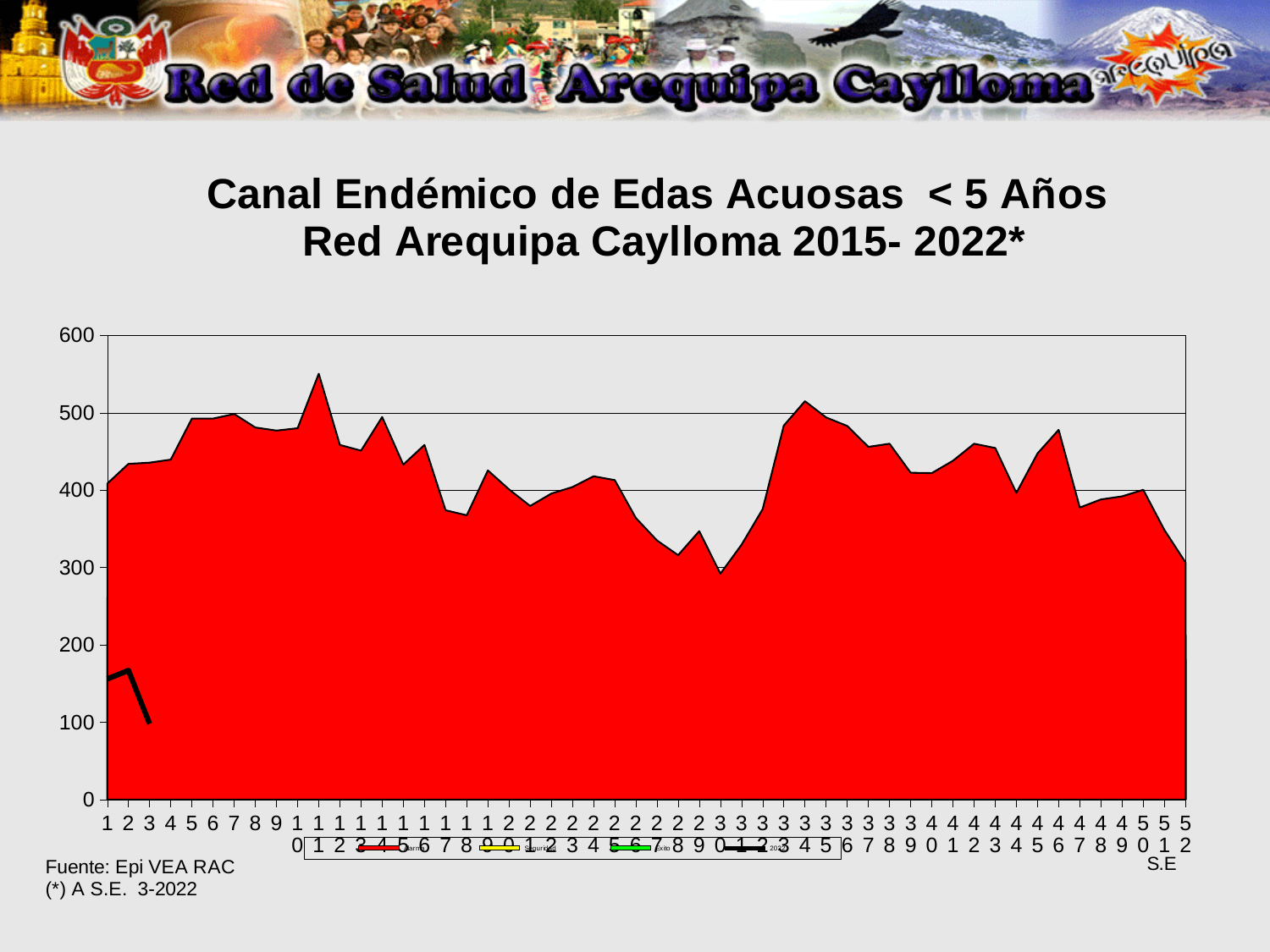
Is the value of the black 2022 line at week 2 greater or less than 100? greater Is the value of the red area at week 11 greater or less than 500? greater What kind of chart is shown on the slide? area and line chart At which week does the red area reach its highest value? 11 Is the value of the red area at week 30 greater or less than 400? less Do the values of the red area rise or fall overall from week 11 to week 30? fall What is the title of the chart? Canal Endémico de Edas Acuosas < 5 Años Red Arequipa Caylloma 2015- 2022* How many epidemiological weeks (S.E.) are shown along the x axis? 52 What is the highest value shown on the y axis? 600